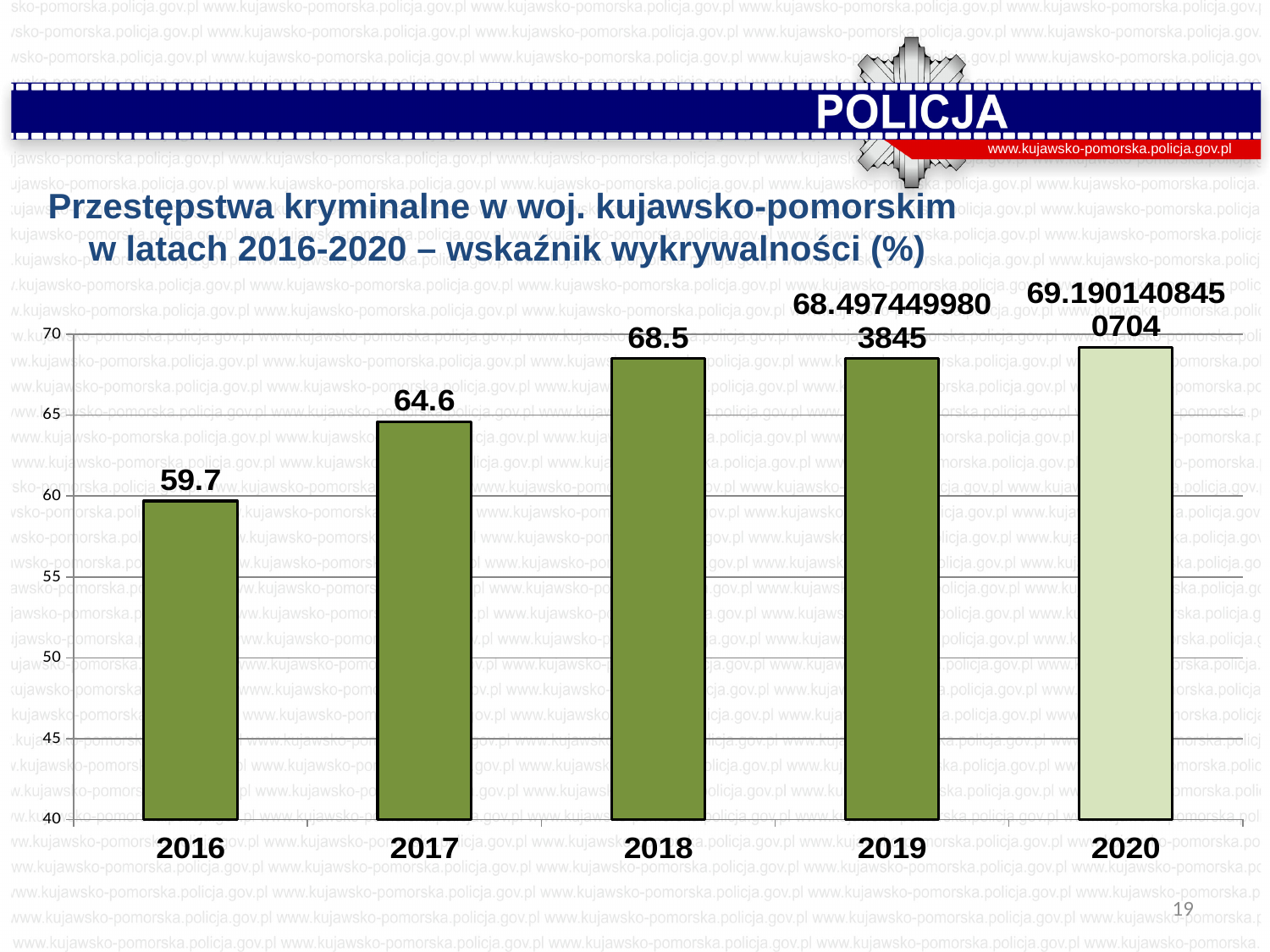
What is the data label shown for 2020? 69.1901408450704 What is the difference between the values for 2017 and 2016? 4.9 Which is larger, the value for 2016 or the value for 2017? 2017 What kind of chart is shown on the slide? bar chart What is the value for 2016? 59.7 What is the value for 2017? 64.6 What is the difference between the values for 2018 and 2017? 3.9 What is the value for 2018? 68.5 Is the value for 2016 greater or less than 60? less Which year has the highest value? 2020 How many years are shown on the x axis? 5 Which year has the lowest value? 2016